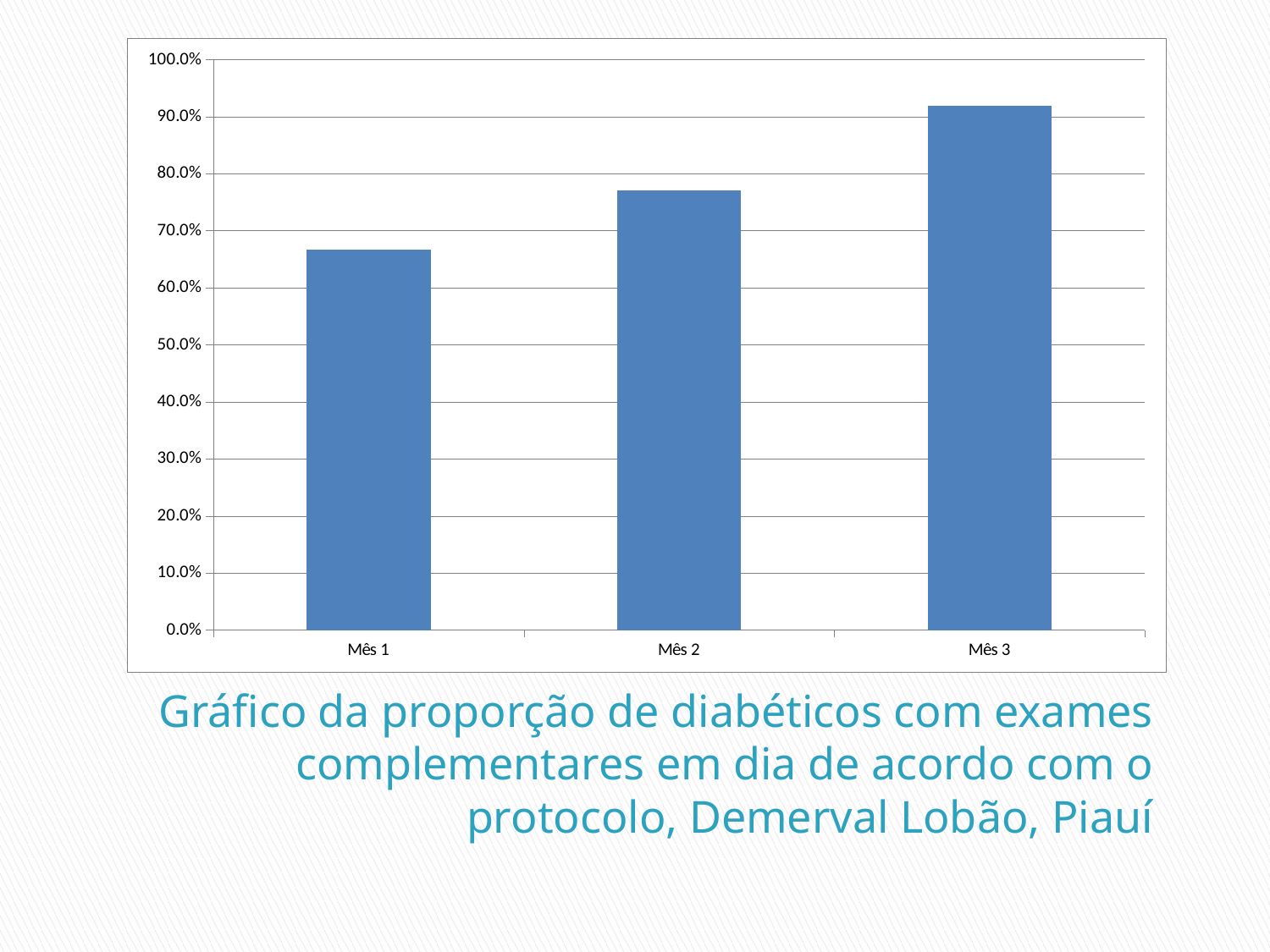
Which is larger, the value for Mês 1 or the value for Mês 2? Mês 2 Which month has the highest proportion on the chart? Mês 3 Is the value for Mês 1 greater or less than 70.0%? less Is the value for Mês 2 greater or less than 70.0%? greater Is the value for Mês 2 greater or less than 80.0%? less Which is larger, the value for Mês 2 or the value for Mês 3? Mês 3 How many categories (months) are plotted on the chart? 3 Do the values rise or fall from Mês 1 to Mês 3? rise What is the maximum value shown on the vertical axis of the chart? 100.0% What kind of chart is shown on the slide? bar chart Which month has the lowest proportion on the chart? Mês 1